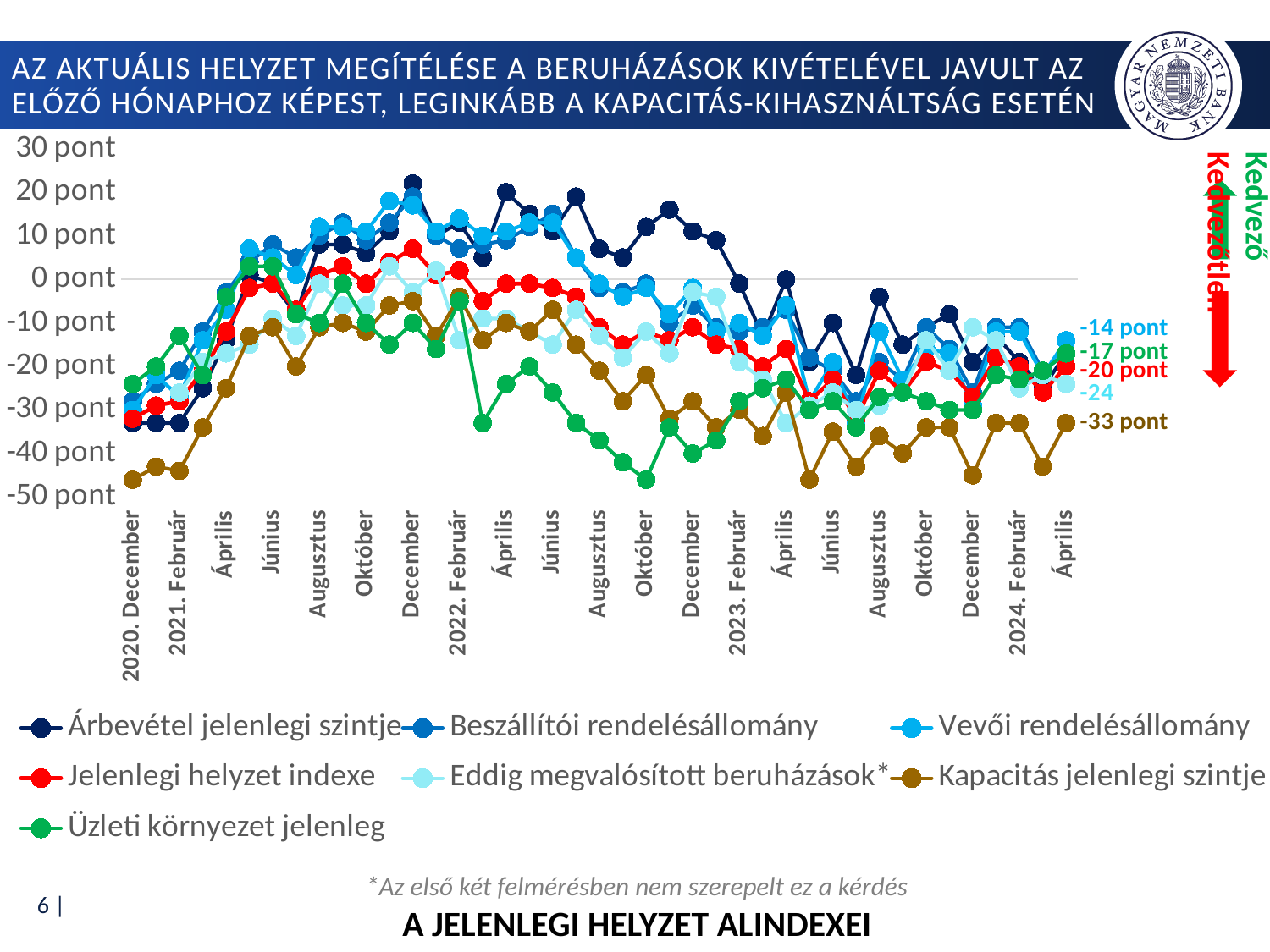
At the last data point, which is higher: Üzleti környezet jelenleg or Jelenlegi helyzet indexe? Üzleti környezet jelenleg What type of chart is shown on the slide? line chart What is the value of Kapacitás jelenlegi szintje at the end of the series (2024 Április)? -33 pont What is the latest value of Vevői rendelésállomány shown at the right end of the chart? -14 pont What is the latest value of Jelenlegi helyzet indexe shown at the right end of the chart? -20 pont What is the title printed below the chart? A JELENLEGI HELYZET ALINDEXEI Does Árbevétel jelenlegi szintje rise or fall between 2020. December and December 2021? rise What is the difference between the latest values of Vevői rendelésállomány (-14 pont) and Kapacitás jelenlegi szintje (-33 pont)? 19 pont Which series has the lowest value at the last data point (2024 Április)? Kapacitás jelenlegi szintje How many series does the legend list? 7 What is the latest value of Üzleti környezet jelenleg shown at the right end of the chart? -17 pont Is the value of Kapacitás jelenlegi szintje in 2020. December greater or less than -40 pont? less